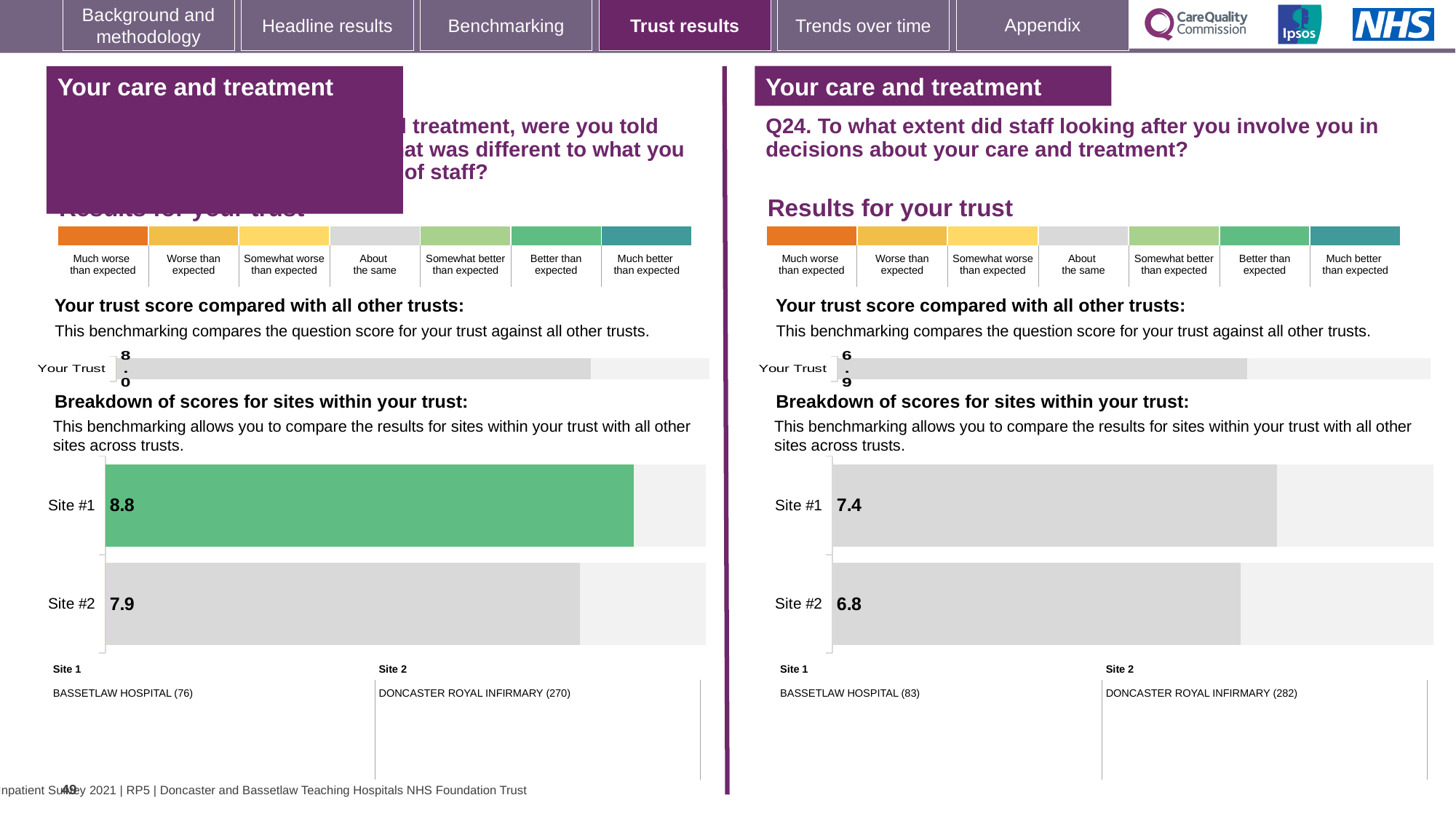
How many sites are shown in the right-hand site breakdown chart (Q24)? 2 On the left-hand site breakdown chart, which site has the lower score? Site #2 On the left-hand site breakdown chart, what is the score for Site #1? 8.8 On the right-hand chart (Q24), which site has the higher score? Site #1 On the right-hand chart (Q24), what is the difference between the Site #1 and Site #2 scores? 0.6 On the right-hand chart (Q24), what is the score for Site #1? 7.4 On the left-hand site breakdown chart, what is the difference between the Site #1 and Site #2 scores? 0.9 On the left-hand site breakdown chart, what is the score for Site #2? 7.9 What type of chart is used for the site breakdown on the left-hand side of the slide? Bar chart On the right-hand chart (Q24), what is the score for Site #2? 6.8 On the left-hand chart, what is the 'Your Trust' score? 8.0 On the right-hand chart (Q24), what is the 'Your Trust' score? 6.9